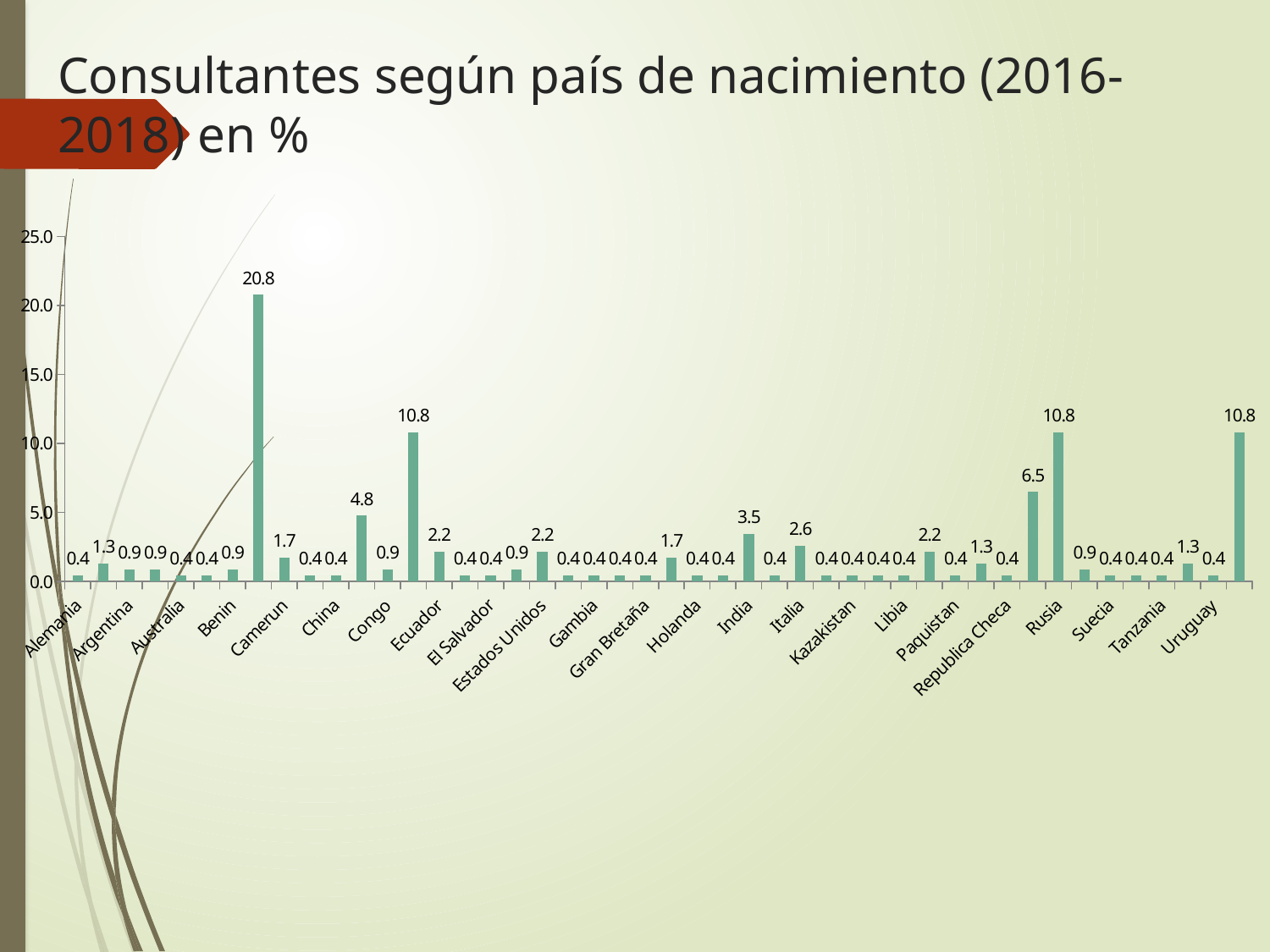
What is the difference between the values for India and Italia? 0.9 How many bars in the chart reach a value of 10.8? 3 What is the value for Camerun? 1.7 What is the value for Ecuador? 2.2 What is the highest value shown in the chart? 20.8 What is the title of the chart? Consultantes según país de nacimiento (2016-2018) en % Is the value for Rusia greater or less than 10.0? greater Which has a larger value, India or Italia? India What is the value for Rusia? 10.8 What is the value for India? 3.5 What kind of chart is shown on the slide? bar chart What is the value for Italia? 2.6